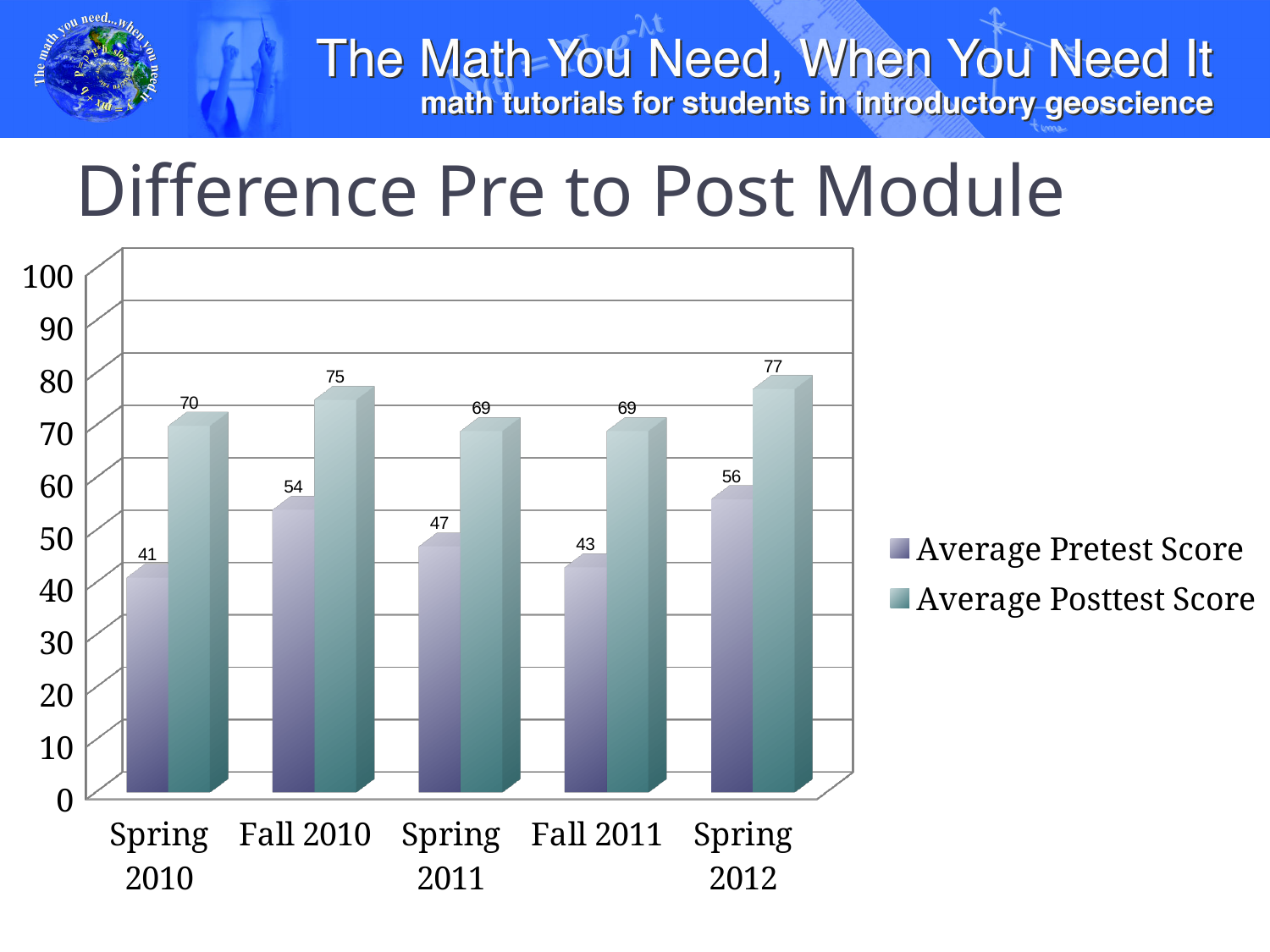
What is the Average Pretest Score for Spring 2010? 41 How many series does the legend list? 2 Which semester has the lowest Average Pretest Score? Spring 2010 What is the title of the chart? Difference Pre to Post Module Which is larger, the Average Pretest Score for Fall 2010 or for Spring 2012? Spring 2012 What is the difference between the Average Posttest Score and the Average Pretest Score for Spring 2010? 29 How many semesters are shown on the x axis? 5 What kind of chart is shown on the slide? Bar chart What is the Average Pretest Score for Fall 2011? 43 What is the difference between the Average Pretest Scores for Fall 2010 and Spring 2011? 7 What is the Average Posttest Score for Spring 2012? 77 Which semester has the highest Average Posttest Score? Spring 2012